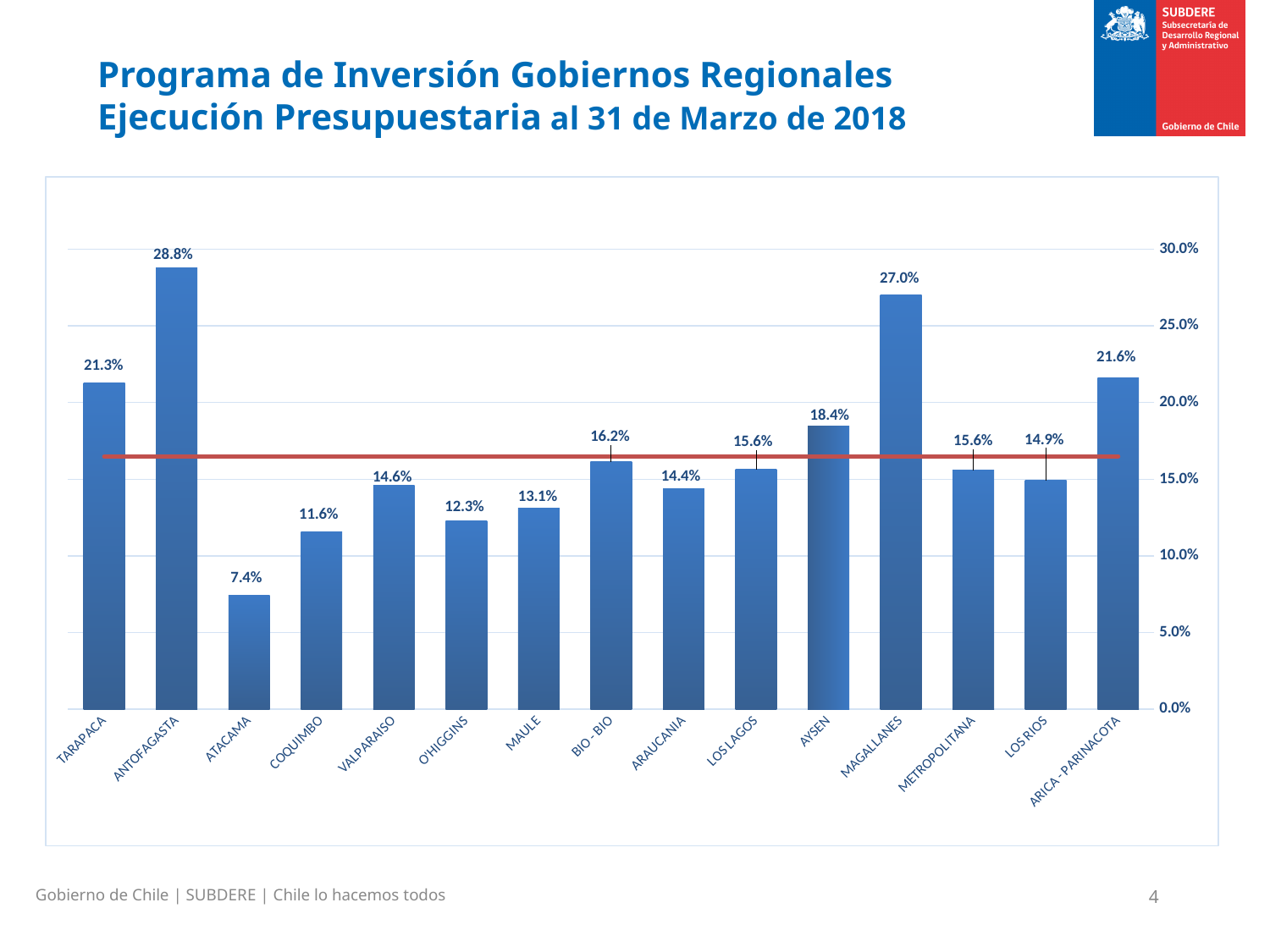
What is the value for ARICA - PARINACOTA? 21.6% Which region has the highest value? ANTOFAGASTA What kind of chart is shown on the slide? bar chart What is the value for ANTOFAGASTA? 28.8% How many regions are shown on the x axis? 15 What is the value for MAGALLANES? 27.0% Is the value for COQUIMBO greater or less than 15.0%? less What is the difference between the values for TARAPACA and ATACAMA? 13.9% Which region has the lowest value? ATACAMA Which is larger, the value for TARAPACA or the value for AYSEN? TARAPACA What is the difference between the values for ANTOFAGASTA and MAGALLANES? 1.8% What is the value for ATACAMA? 7.4%